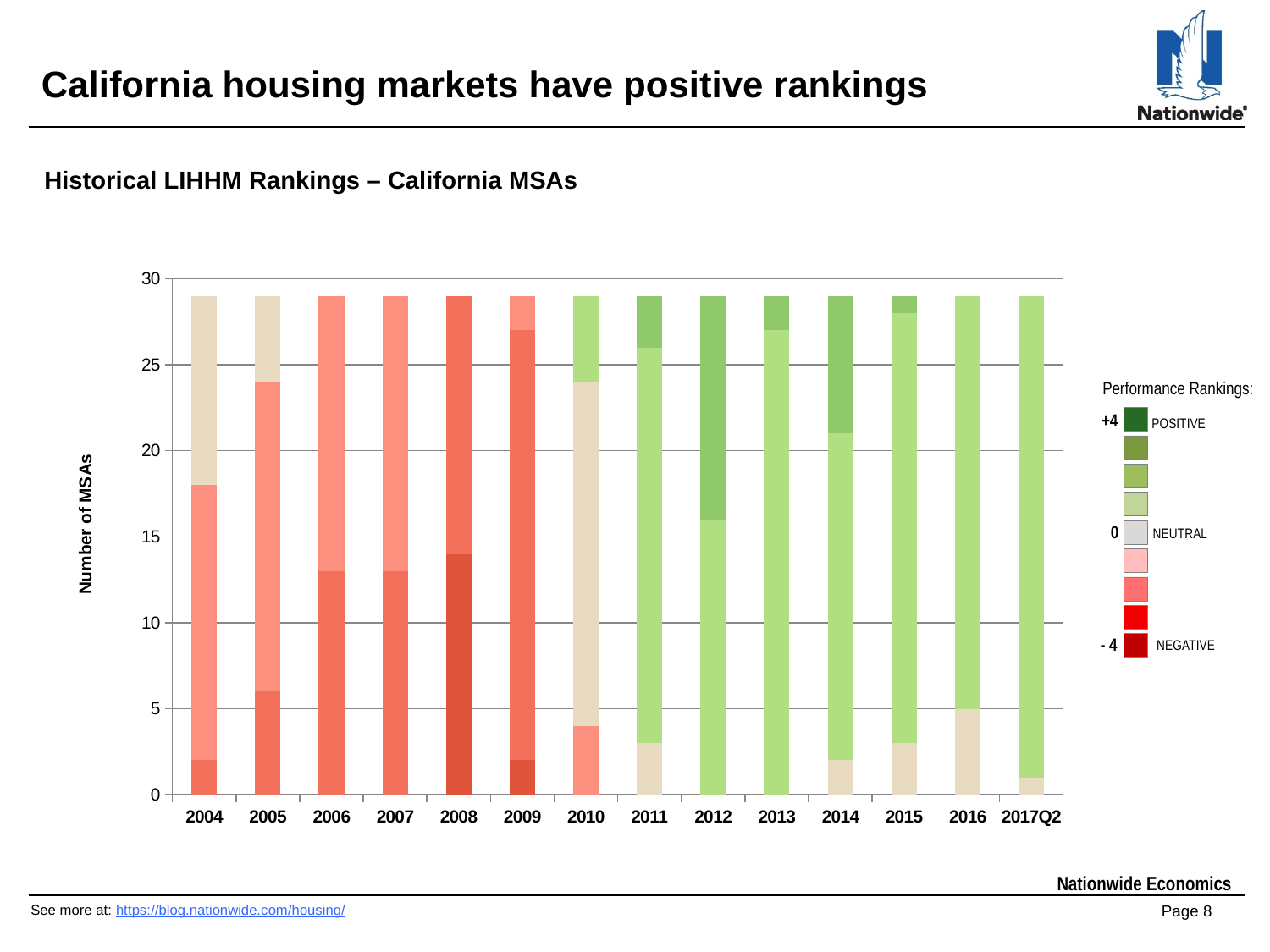
What kind of chart is shown on the slide? Stacked bar chart Is the total height of the 2004 bar greater or less than 25? greater Which year is the first in which the bar is entirely green (positive)? 2012 Which year has the largest dark green (most positive) segment? 2012 Is the neutral (beige) segment of the 2010 bar greater or less than 15 MSAs? greater What is the label on the vertical axis of the chart? Number of MSAs What is the title of the chart? Historical LIHHM Rankings – California MSAs How many years (categories) are shown along the x axis of the chart? 14 Over the years shown, do the bars shift from negative (red) rankings to positive (green) rankings, or from positive to negative? From negative to positive Which year has the largest neutral (beige) segment? 2010 Is the neutral segment larger in 2010 or in 2016? 2010 Is the dark green segment larger in 2011 or in 2012? 2012